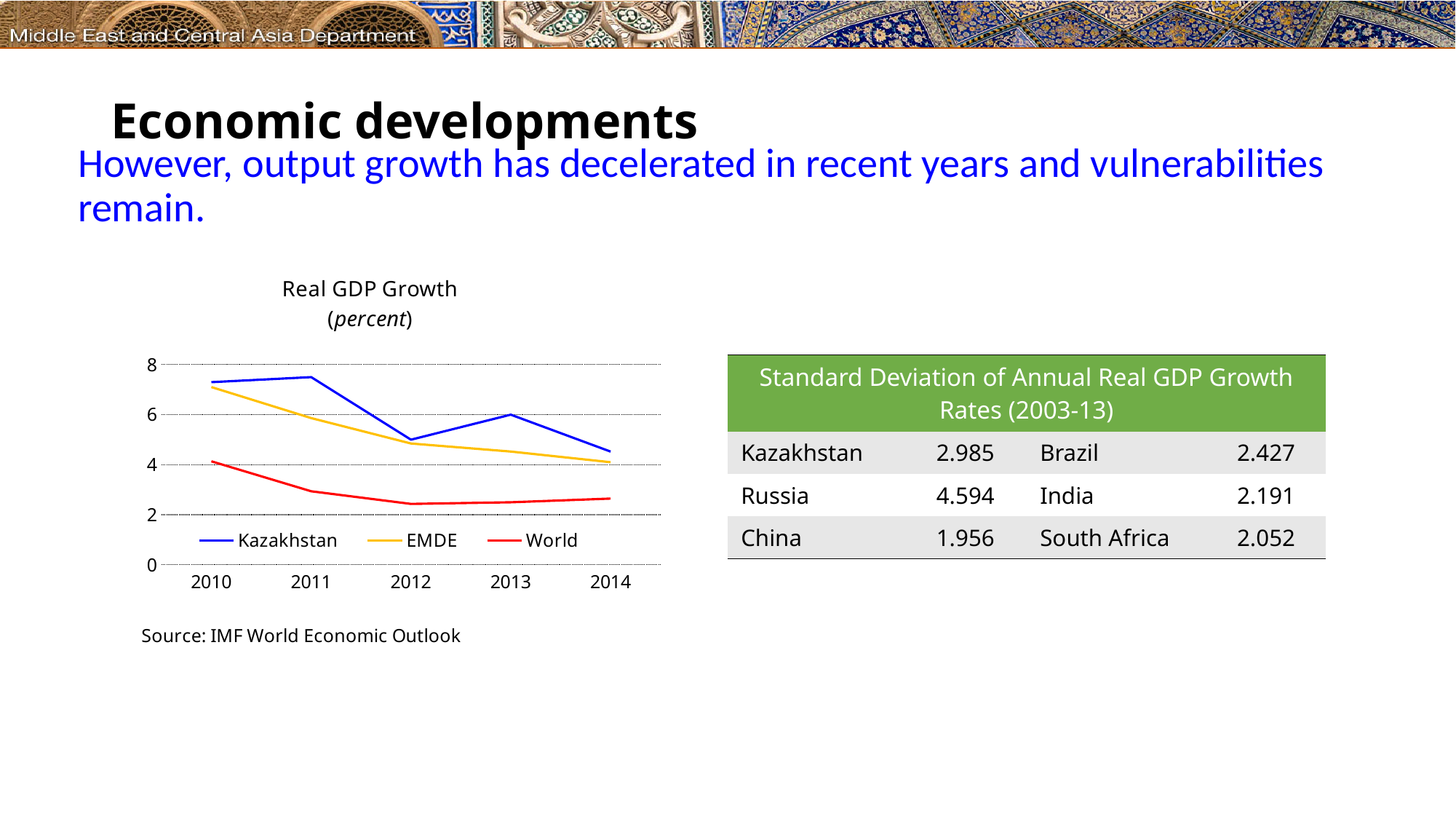
Is the value for World in 2010 greater or less than 2? greater How many years are plotted on the x axis of the Real GDP Growth chart? 5 What is the title of the chart on the slide? Real GDP Growth (percent) Which series has the lowest value in 2010? World How many series does the legend of the Real GDP Growth chart list? 3 Is the value for World in 2012 greater or less than 4? less Is the value for EMDE in 2014 greater or less than 6? less What kind of chart is shown on the slide? line chart Does the EMDE line rise or fall from 2010 to 2014? fall Which colour is used for the Kazakhstan line in the Real GDP Growth chart? blue Which series has the highest value in 2011? Kazakhstan